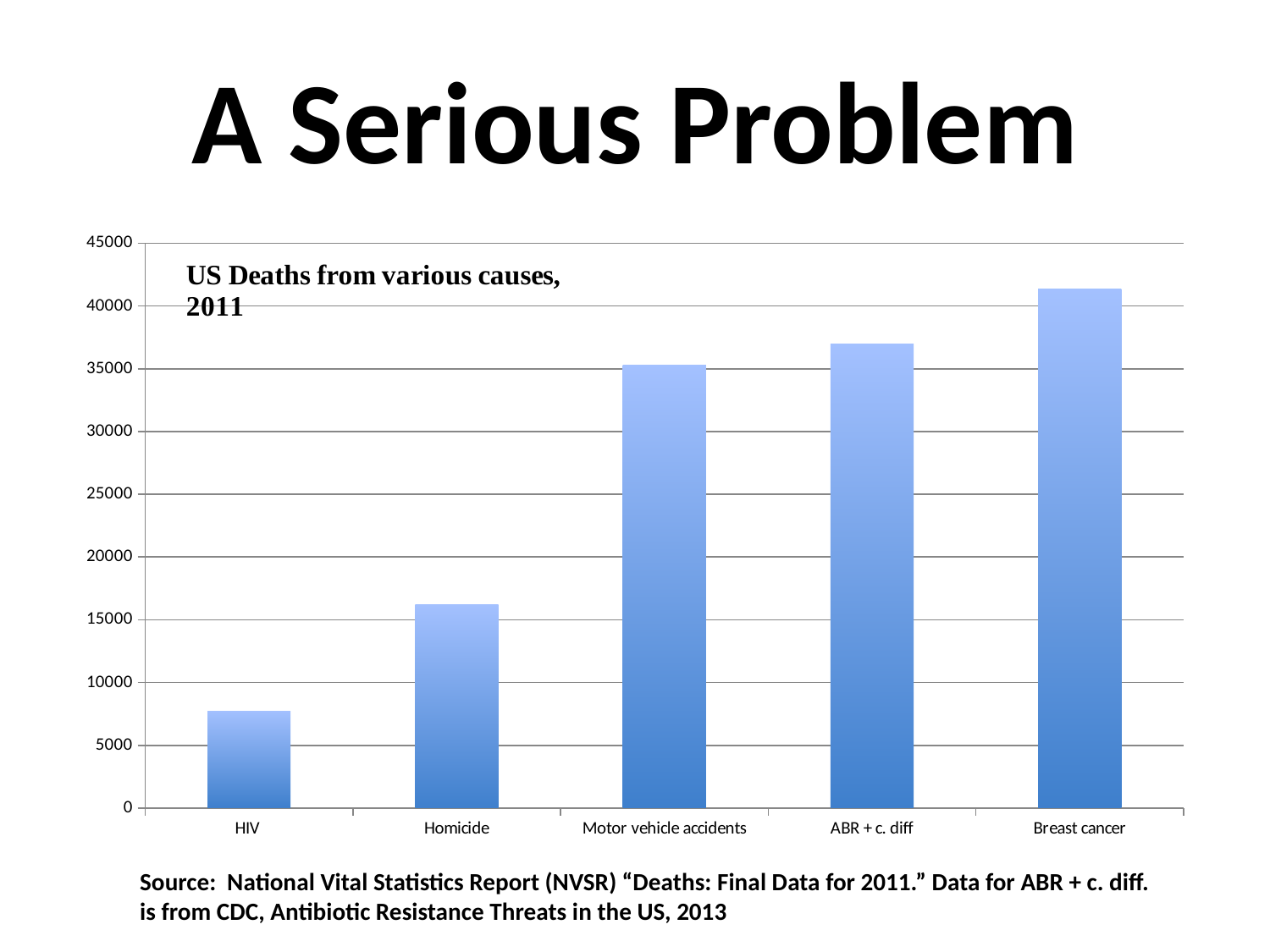
Is the value for ABR + c. diff greater or less than 35000? greater Is the value for Homicide greater or less than 20000? less Do the values rise or fall moving from left to right across the categories? rise Which cause of death has the lowest number of deaths in the chart? HIV Is the value for Breast cancer greater or less than 40000? greater Which has more deaths, Homicide or HIV? Homicide Which cause of death has the highest number of deaths in the chart? Breast cancer What is the title of the chart? US Deaths from various causes, 2011 What kind of chart is shown on the slide? bar chart How many causes of death are plotted in the chart? 5